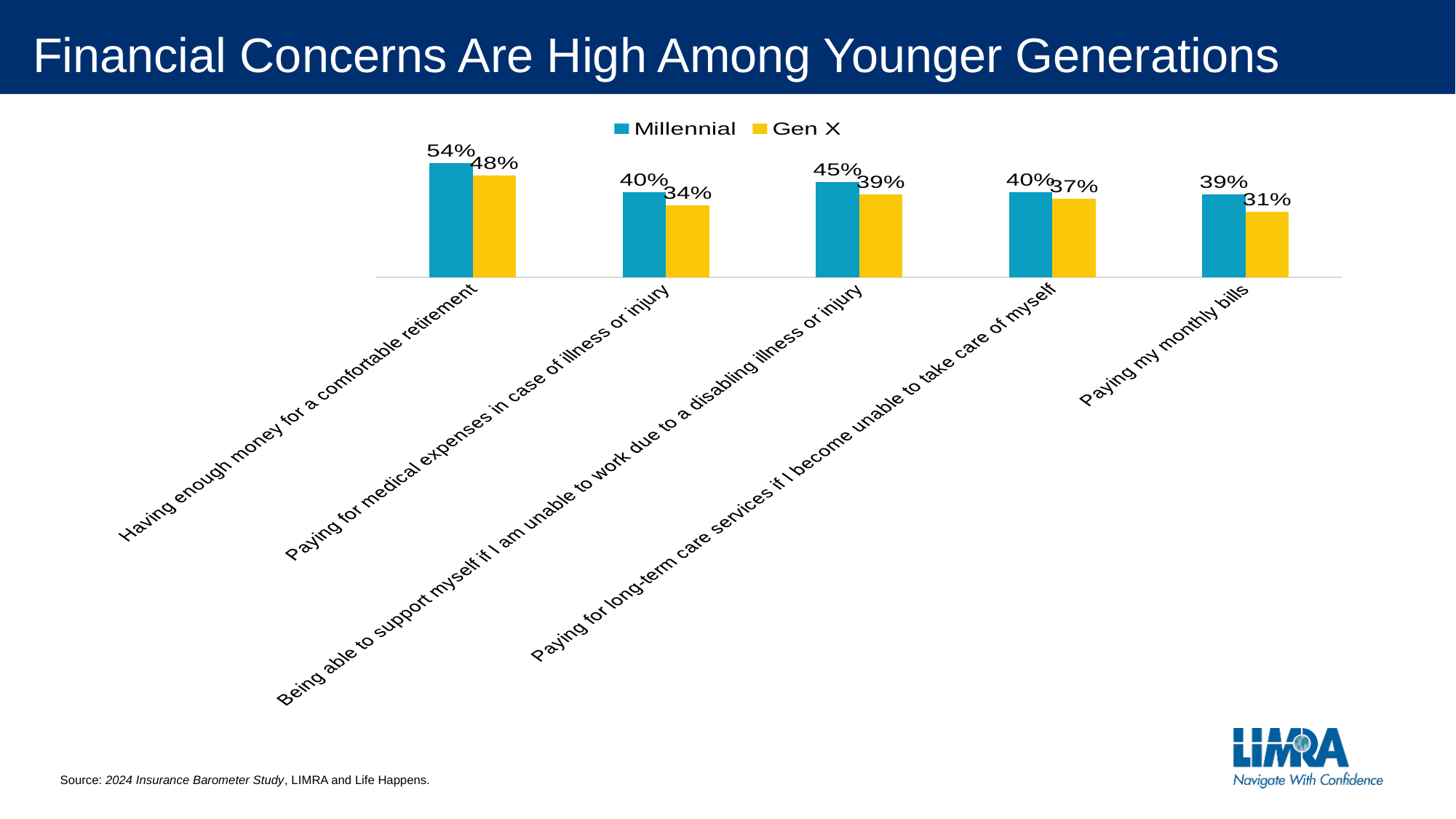
Which category has the highest Millennial value? Having enough money for a comfortable retirement What kind of chart is shown on the slide? Bar chart What is the Millennial value for "Being able to support myself if I am unable to work due to a disabling illness or injury"? 45% Which category has the lowest Gen X value? Paying my monthly bills Which is larger: the Millennial value for "Paying for long-term care services if I become unable to take care of myself" or the Gen X value for the same category? Millennial What is the Millennial value for "Having enough money for a comfortable retirement"? 54% What is the Gen X value for "Paying my monthly bills"? 31% How many categories are shown on the x axis? 5 What is the Gen X value for "Paying for medical expenses in case of illness or injury"? 34% What is the difference between the Millennial and Gen X values for "Having enough money for a comfortable retirement"? 6% How many series does the legend list? 2 What is the difference between the Millennial and Gen X values for "Paying my monthly bills"? 8%